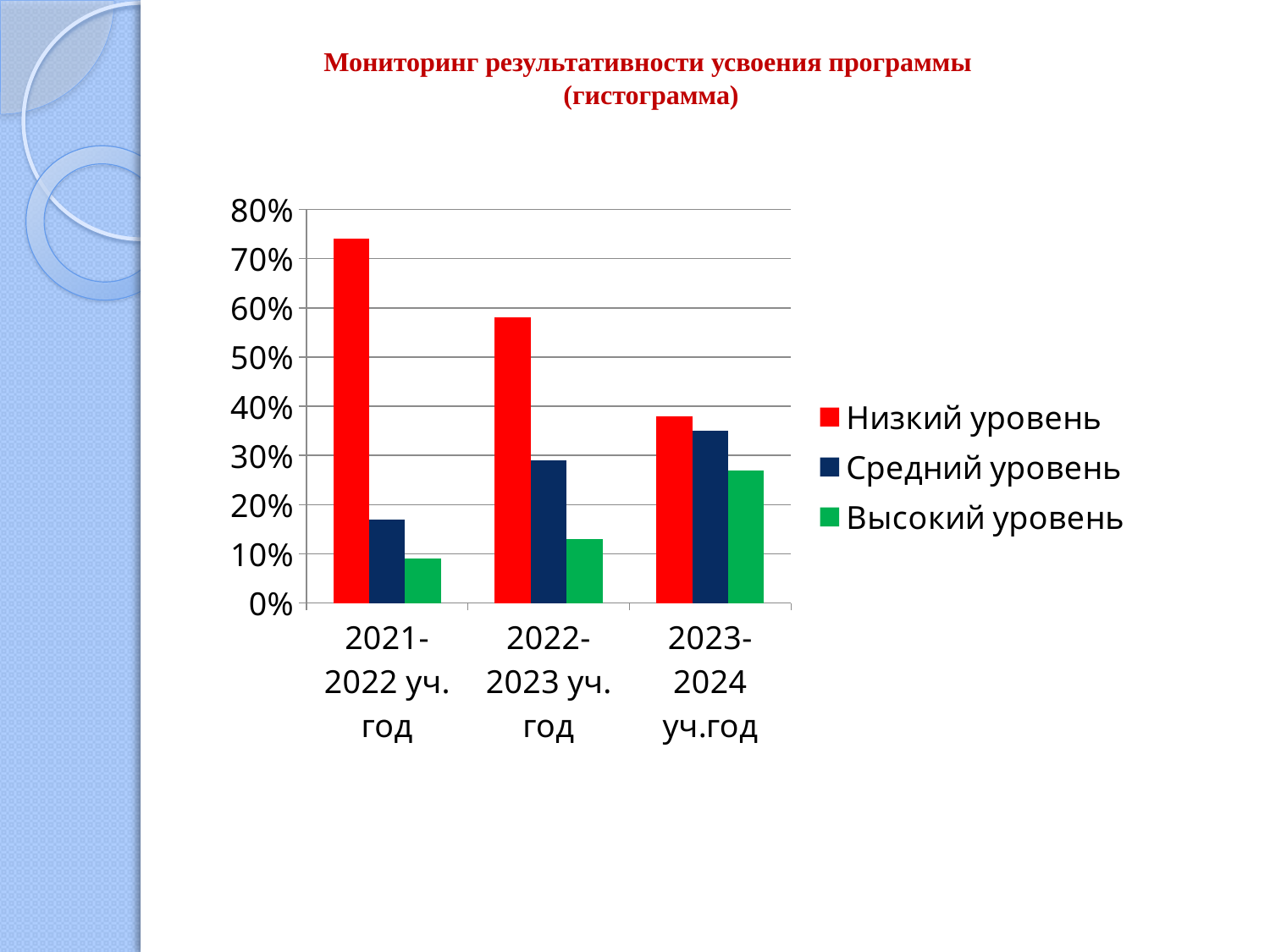
How many series does the legend list? 3 In which academic year is Высокий уровень lowest? 2021-2022 уч. год What kind of chart is shown on the slide? bar chart Is the value for Низкий уровень in 2021-2022 уч. год greater or less than 70%? greater Is the value for Низкий уровень in 2022-2023 уч. год greater or less than 50%? greater How many academic-year categories are shown on the x axis? 3 What is the title of the slide above the chart? Мониторинг результативности усвоения программы (гистограмма) Is the value for Высокий уровень in 2021-2022 уч. год greater or less than 10%? less In which academic year is Низкий уровень highest? 2021-2022 уч. год Does the value for Низкий уровень rise or fall across the academic years from 2021-2022 to 2023-2024? fall Which series is shown in red in the legend? Низкий уровень